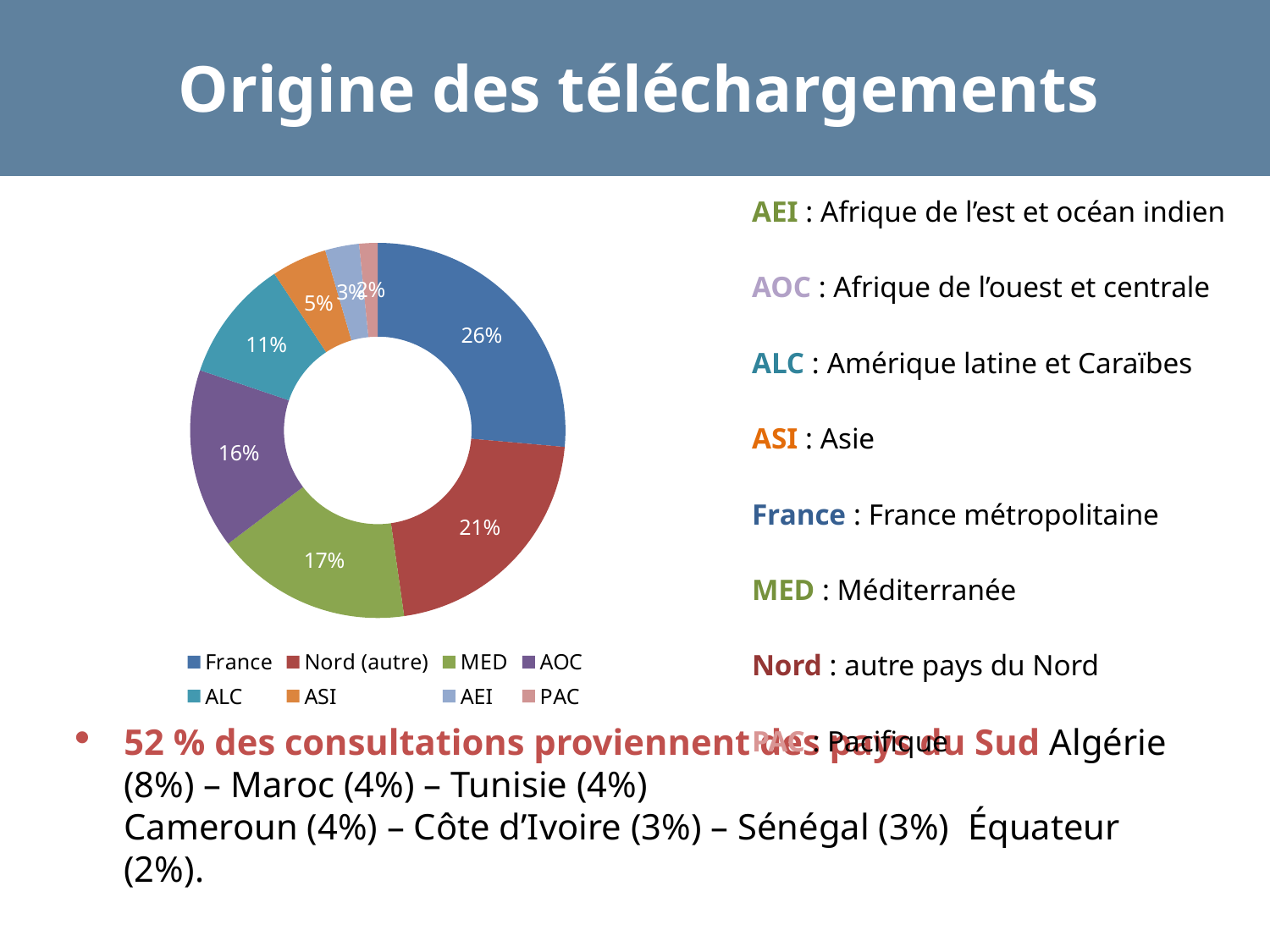
Which is larger, the share for MED or the share for AOC? MED What percentage is shown for MED? 17% What percentage is shown for Nord (autre)? 21% What is the difference in percentage points between France and Nord (autre)? 5 Which category has the largest share of the chart? France What is the title of the slide containing the chart? Origine des téléchargements What share of downloads comes from France? 26% What percentage is shown for ASI? 5% How many categories does the legend of the chart list? 8 What percentage is shown for ALC? 11% What percentage is shown for AOC? 16% What type of chart is shown on the slide? doughnut chart